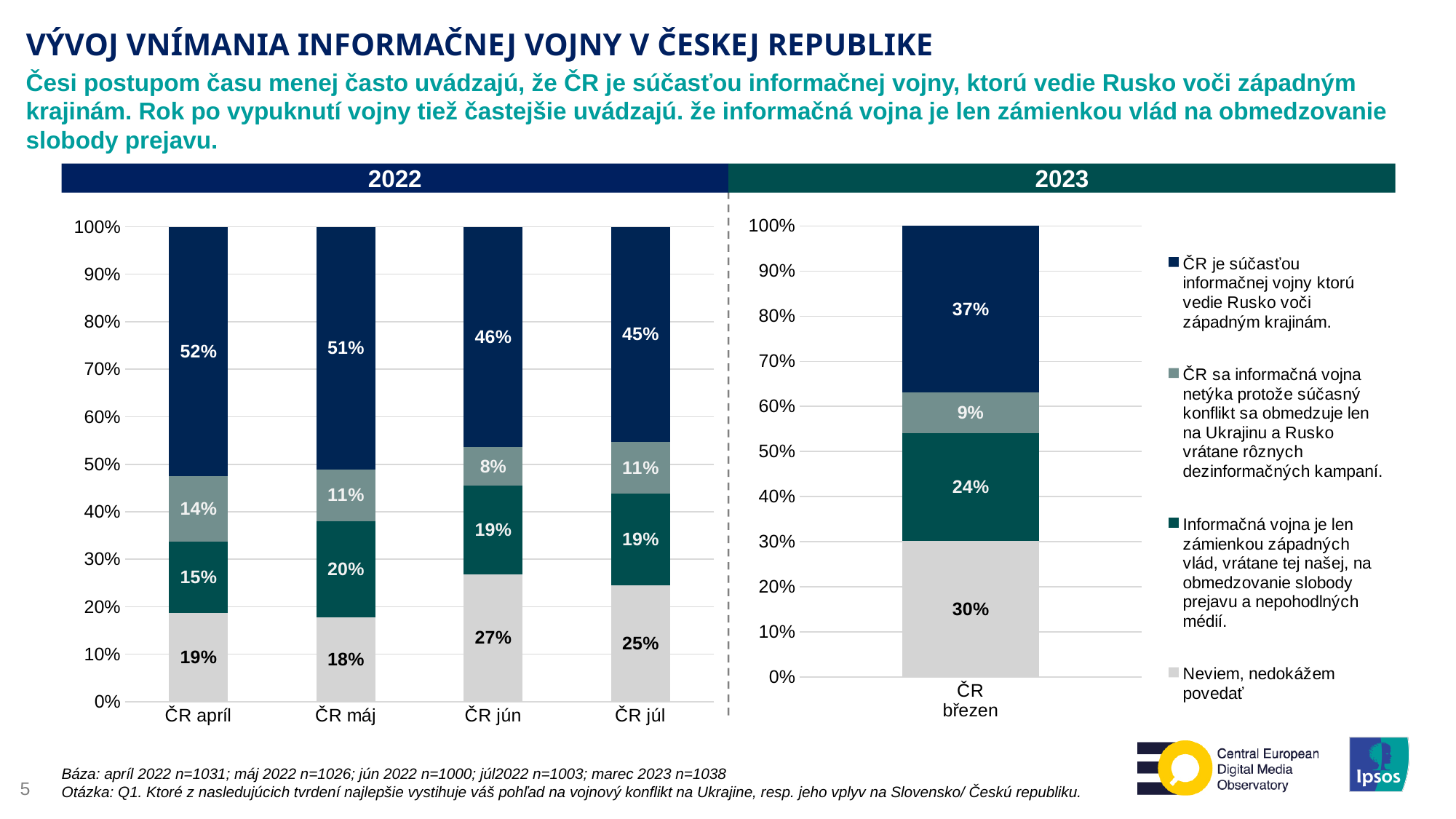
In the 2022 chart, what is the value of the 'Informačná vojna je len zámienkou západných vlád...' segment for ČR máj? 20% In the 2022 chart, what percentage of respondents in ČR apríl said ČR is part of the information war led by Russia against Western countries? 52% How many series does the legend list? 4 In the 2022 chart, which month has the lowest value for 'Neviem, nedokážem povedať'? ČR máj In the 2022 chart, what is the difference between the 'ČR je súčasťou informačnej vojny...' values for ČR apríl and ČR júl? 7% In the 2022 chart, which month has the highest value for 'ČR je súčasťou informačnej vojny ktorú vedie Rusko voči západným krajinám'? ČR apríl What type of chart is used on this slide? Stacked bar chart How many bars are plotted in the 2022 chart? 4 In the 2022 chart, does the 'ČR je súčasťou informačnej vojny...' value rise or fall from ČR apríl to ČR júl? Fall In the 2023 chart, what is the value of the 'Neviem, nedokážem povedať' segment for ČR březen? 30% In the 2023 chart, what is the value of the 'ČR sa informačná vojna netýka...' segment for ČR březen? 9% Which is larger in the 2022 chart: the 'Neviem, nedokážem povedať' value for ČR jún or for ČR júl? ČR jún